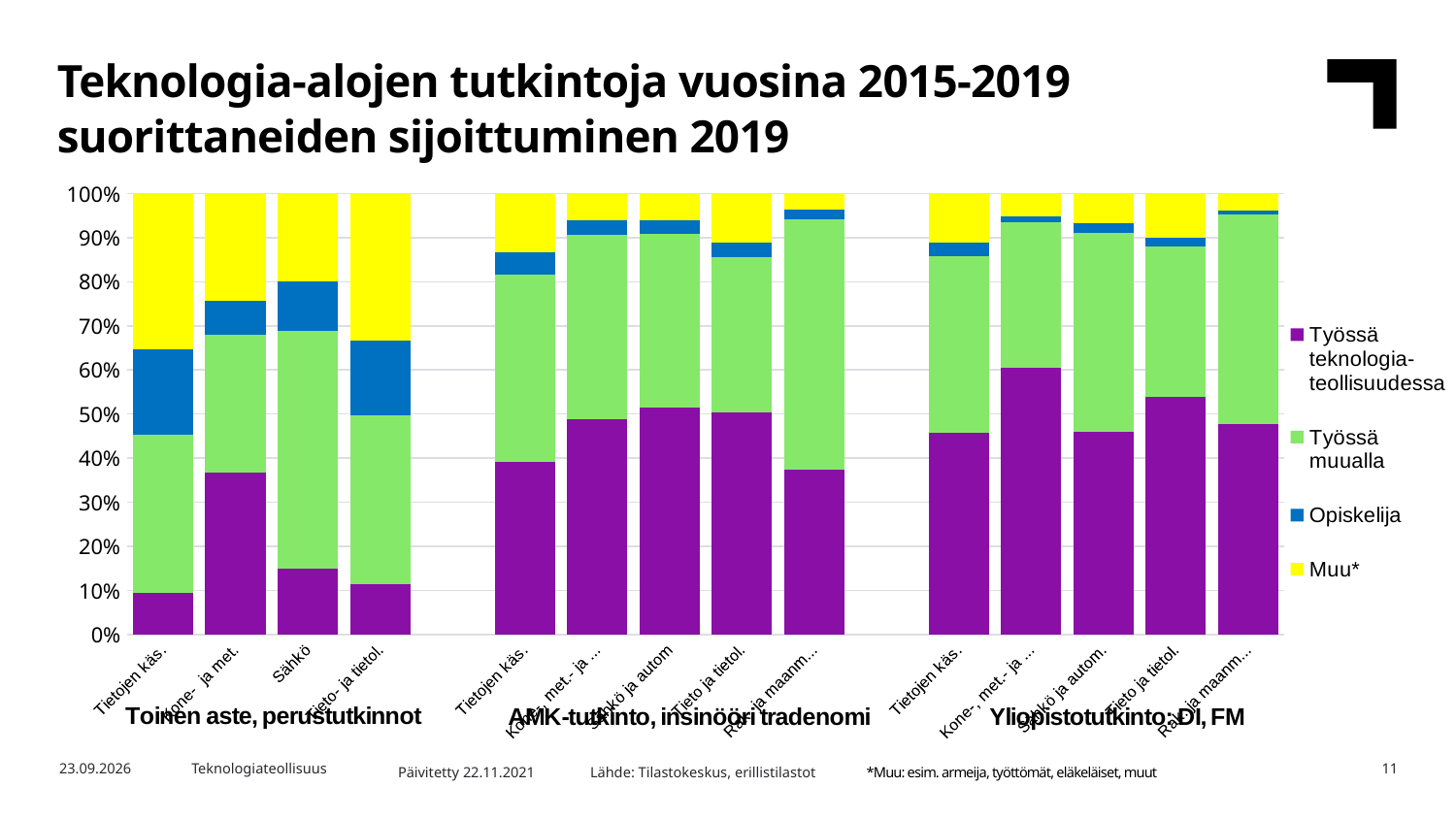
Is the 'Työssä teknologiateollisuudessa' share for 'Tietojen käs.' in the 'Toinen aste, perustutkinnot' group greater or less than 20%? less How many series does the legend list? 4 Which has the larger 'Työssä teknologiateollisuudessa' share: 'Tietojen käs.' in the AMK group or 'Tietojen käs.' in the Yliopistotutkinto group? Tietojen käs. in the Yliopistotutkinto group Is the 'Työssä teknologiateollisuudessa' share for 'Kone-, met- ja ...' in the 'Yliopistotutkinto: DI, FM' group greater or less than 50%? greater Is the 'Muu*' share for 'Tietojen käs.' in the 'Toinen aste, perustutkinnot' group greater or less than 30%? greater Which colour represents the 'Opiskelija' series in the chart? Blue How many bars are plotted in the chart in total? 14 How many bars are in the 'Yliopistotutkinto: DI, FM' group? 5 What kind of chart is shown on the slide? Stacked bar chart Which bar has the smallest 'Työssä teknologiateollisuudessa' share? Tietojen käs. (Toinen aste, perustutkinnot) Which bar has the largest 'Työssä teknologiateollisuudessa' share? Kone-, met- ja ... (Yliopistotutkinto: DI, FM) How many bars are in the 'Toinen aste, perustutkinnot' group? 4